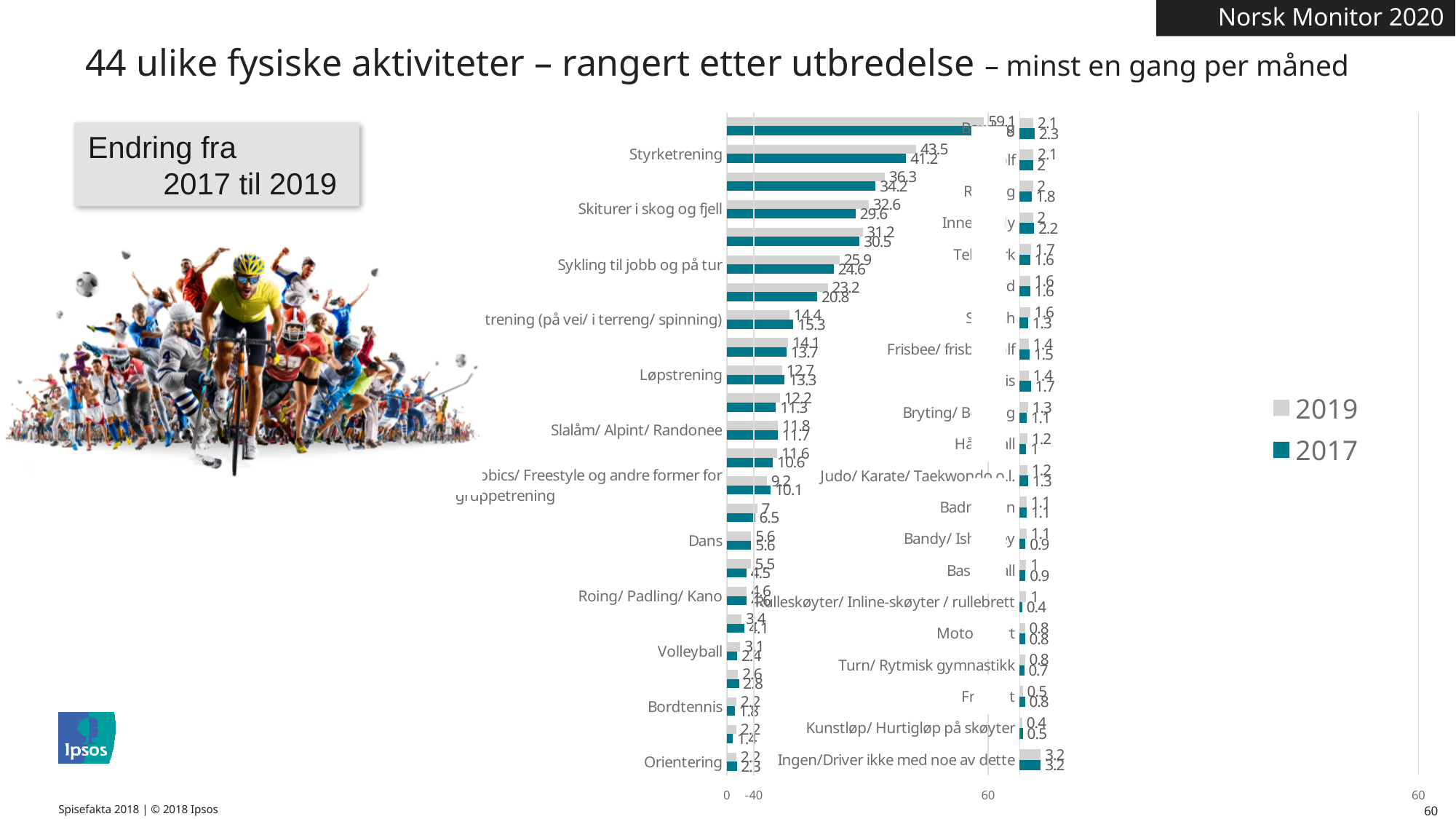
On the right chart, what is the 2019 value for Ingen/Driver ikke med noe av dette? 3.2 On the left chart, what is the 2017 value for Sykling til jobb og på tur? 24.6 On the left chart, what is the difference between the 2019 and 2017 values for Styrketrening? 2.3 On the right chart, what is the 2017 value for Kunstløp/ Hurtigløp på skøyter? 0.5 On the left chart, which year has the larger value for Volleyball, 2019 or 2017? 2019 On the left chart, what is the 2019 value for Løpstrening? 12.7 On the left chart, what is the 2019 value for Skiturer i skog og fjell? 32.6 What kind of chart is used on this slide? bar chart On the left chart, what is the 2019 value for Styrketrening? 43.5 How many series does the legend list? 2 On the left chart, what is the 2017 value for Styrketrening? 41.2 On the left chart, which year has the larger value for Løpstrening, 2019 or 2017? 2017